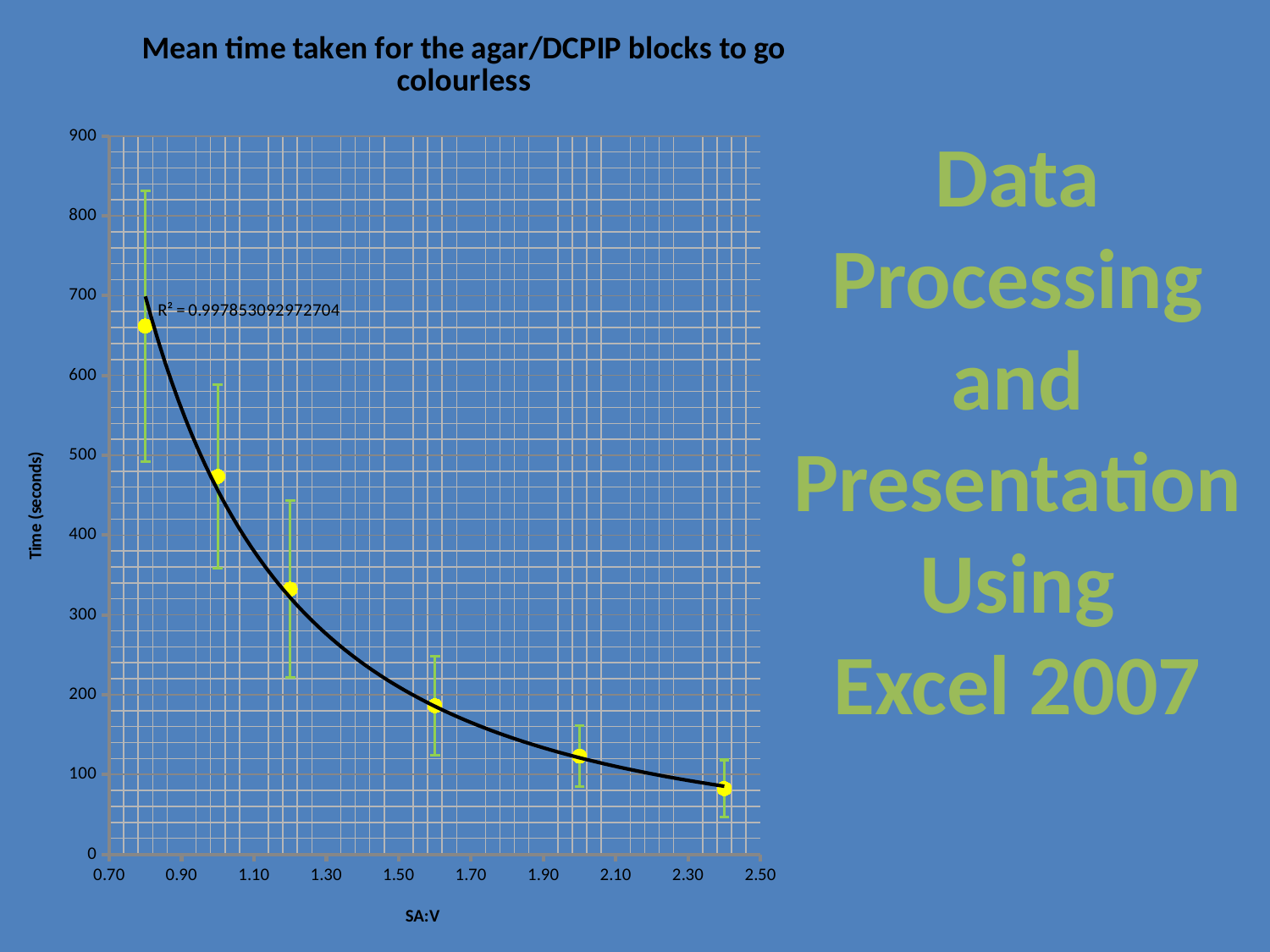
Is the mean time at SA:V 2.40 greater or less than 100 seconds? less At which SA:V value is the mean time highest? 0.80 Do the plotted time values rise or fall as SA:V increases along the x axis? Fall At which SA:V value is the mean time lowest? 2.40 How many data points are plotted on the chart? 6 Is the mean time at SA:V 1.60 greater or less than 200 seconds? less Is the mean time at SA:V 1.00 greater or less than 400 seconds? greater What R² value is displayed on the chart? 0.997853092972704 Which has the larger mean time: SA:V 1.20 or SA:V 2.00? SA:V 1.20 What kind of chart is shown on the slide? Scatter chart What is the title of the chart? Mean time taken for the agar/DCPIP blocks to go colourless